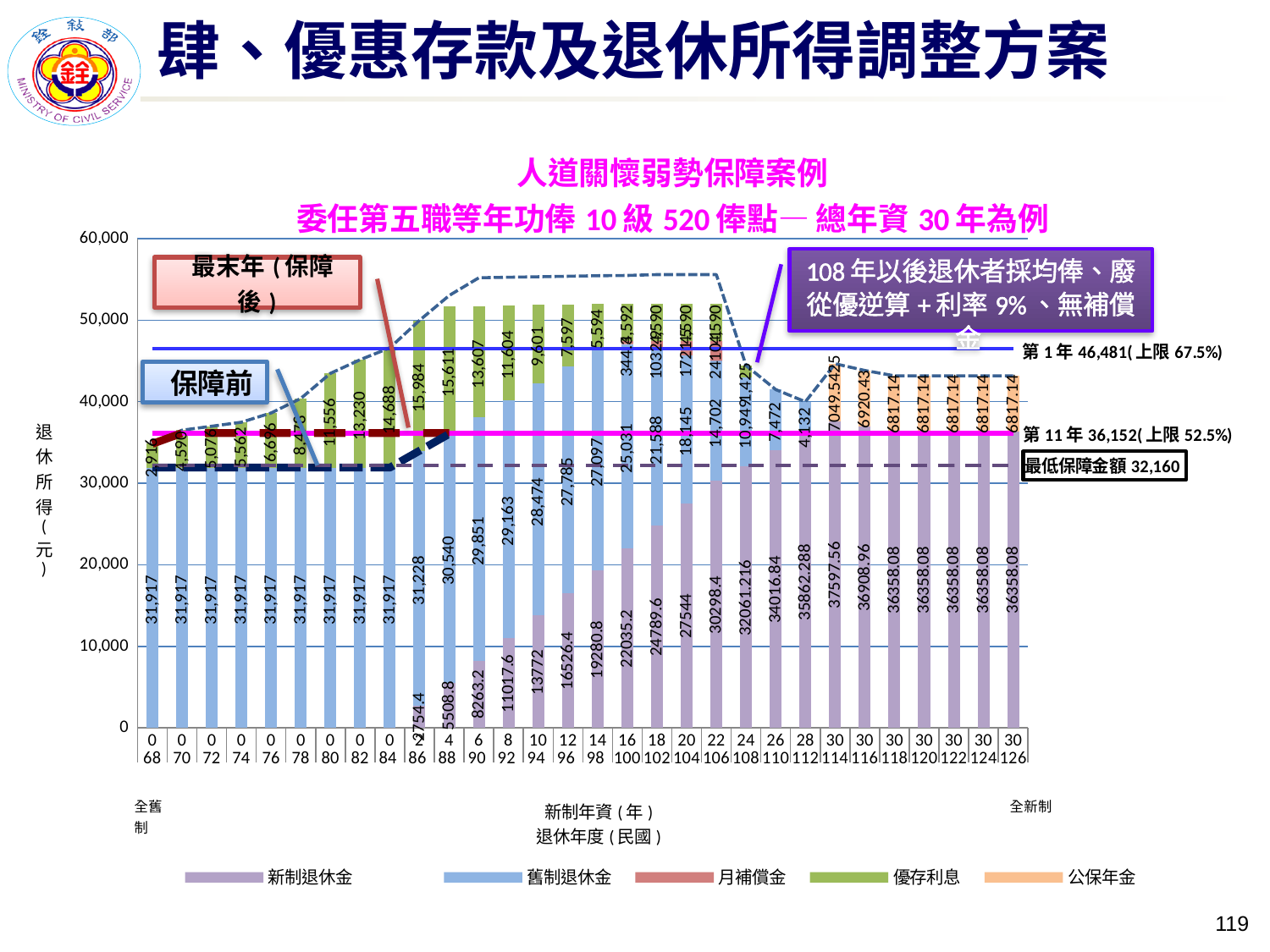
Does the 舊制退休金 series rise or fall from the bar 4 / 88 to the bar 28 / 112? fall Which bar has the larger 舊制退休金 value, 24 / 108 or 28 / 112? 24 / 108 How many series does the legend list? 5 What is the difference between 新制退休金 at 30 / 114 (37597.56) and at 30 / 116 (36908.96)? 688.60 How many bars (retirement-year categories) are plotted on the x axis? 30 What is the value of 新制退休金 for the bar labelled 30 / 114? 37597.56 What is the value of 優存利息 for the bar labelled 4 / 88? 15,611 What value is shown for the horizontal line labelled 最低保障金額? 32,160 What is the value of 舊制退休金 for the first bar (0 / 68)? 31,917 What is the value of 公保年金 for the bar labelled 30 / 126? 6817.14 What is the total of the stacked bar labelled 0 / 68 (舊制退休金 31,917 plus 優存利息 2,916)? 34,833 What kind of chart is shown on the slide? combination chart of stacked bars and lines